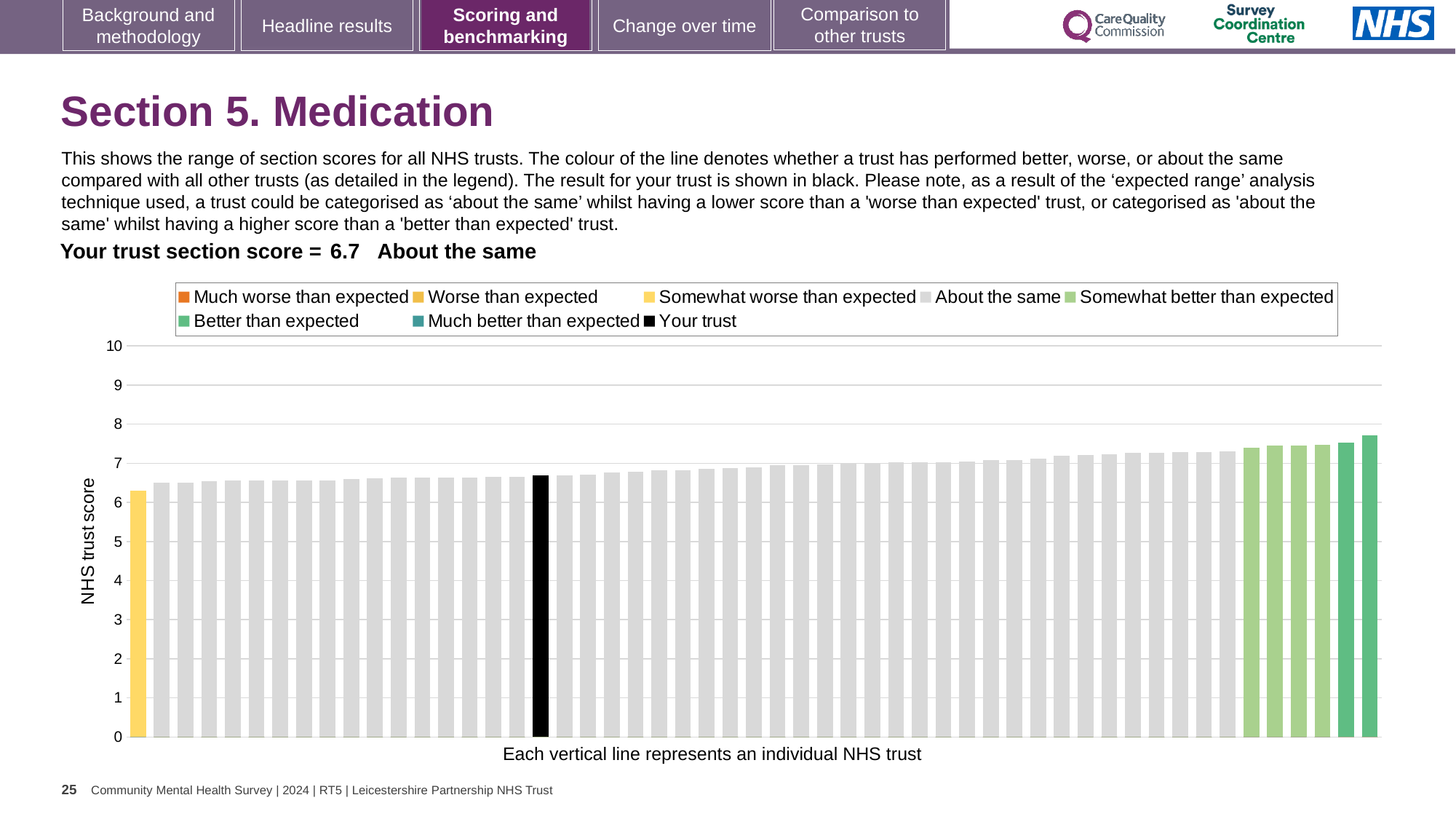
What kind of chart is shown on the slide? bar chart How many bars in the chart are coloured yellow? 1 Do the bar values rise or fall from left to right along the x axis? rise How many entries does the chart legend list? 8 Is the value of the rightmost bar greater or less than 7? greater Is the value of the rightmost bar greater or less than 8? less Is the value of the leftmost bar greater or less than 7? less How is your trust's section score categorised compared with other trusts? About the same What is the section score for your trust shown on the slide? 6.7 What is the label on the vertical axis of the chart? NHS trust score What colour is the bar representing your trust? black